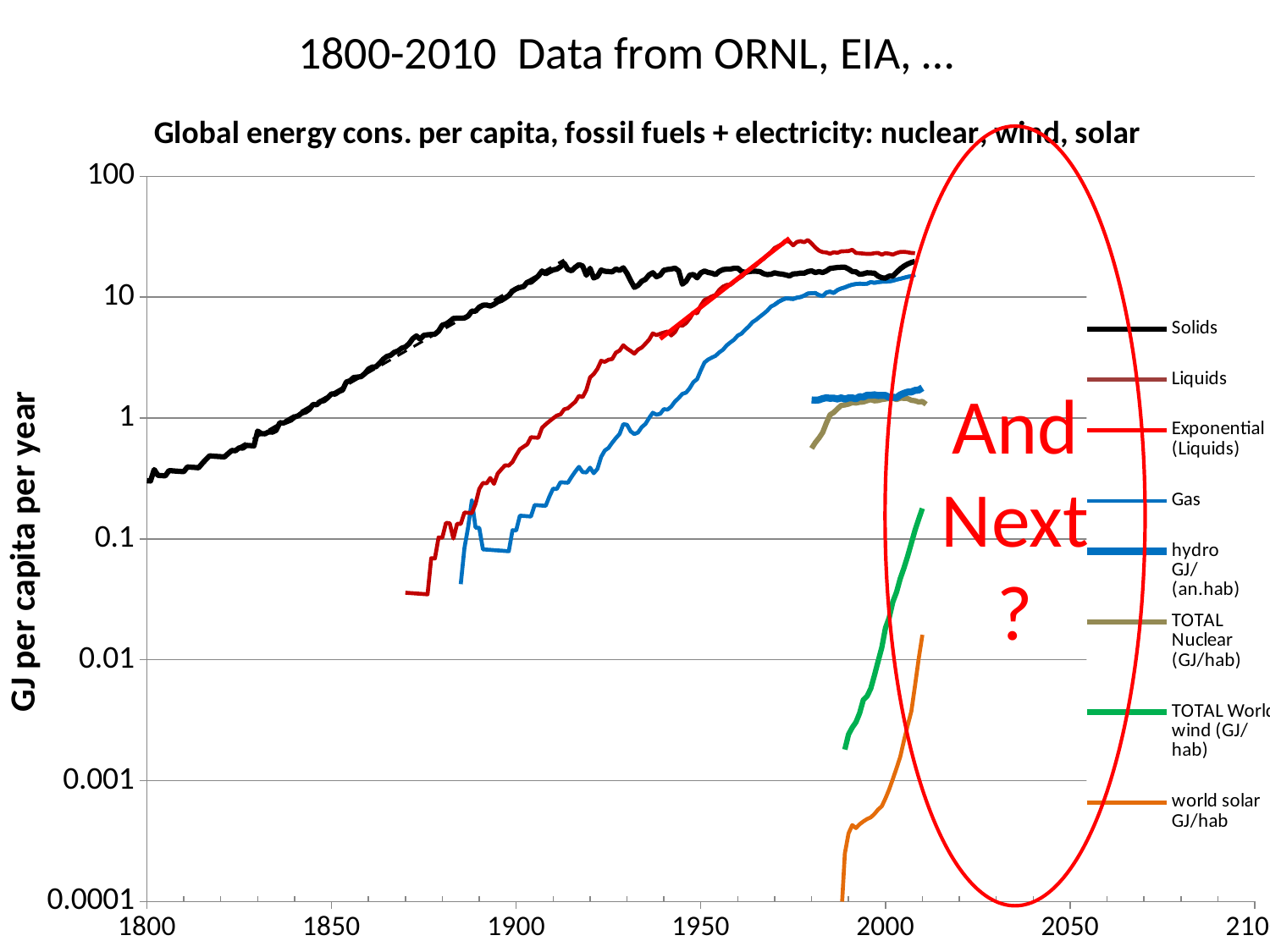
How many series does the legend list? 8 What is the label of the vertical axis? GJ per capita per year Is the value for TOTAL World wind (GJ/hab) in 2010 greater or less than 1? less What kind of chart is shown on the slide? line chart Is the value for Gas in 1900 greater or less than 1? less Is the value for Liquids around 2000 greater or less than 10? greater Around 2000, which is larger, Liquids or Solids? Liquids In 2010, which is larger, TOTAL World wind (GJ/hab) or world solar GJ/hab? TOTAL World wind (GJ/hab) Does the Solids series rise or fall between 1800 and 1900? rise What is the title of the chart? Global energy cons. per capita, fossil fuels + electricity: nuclear, wind, solar